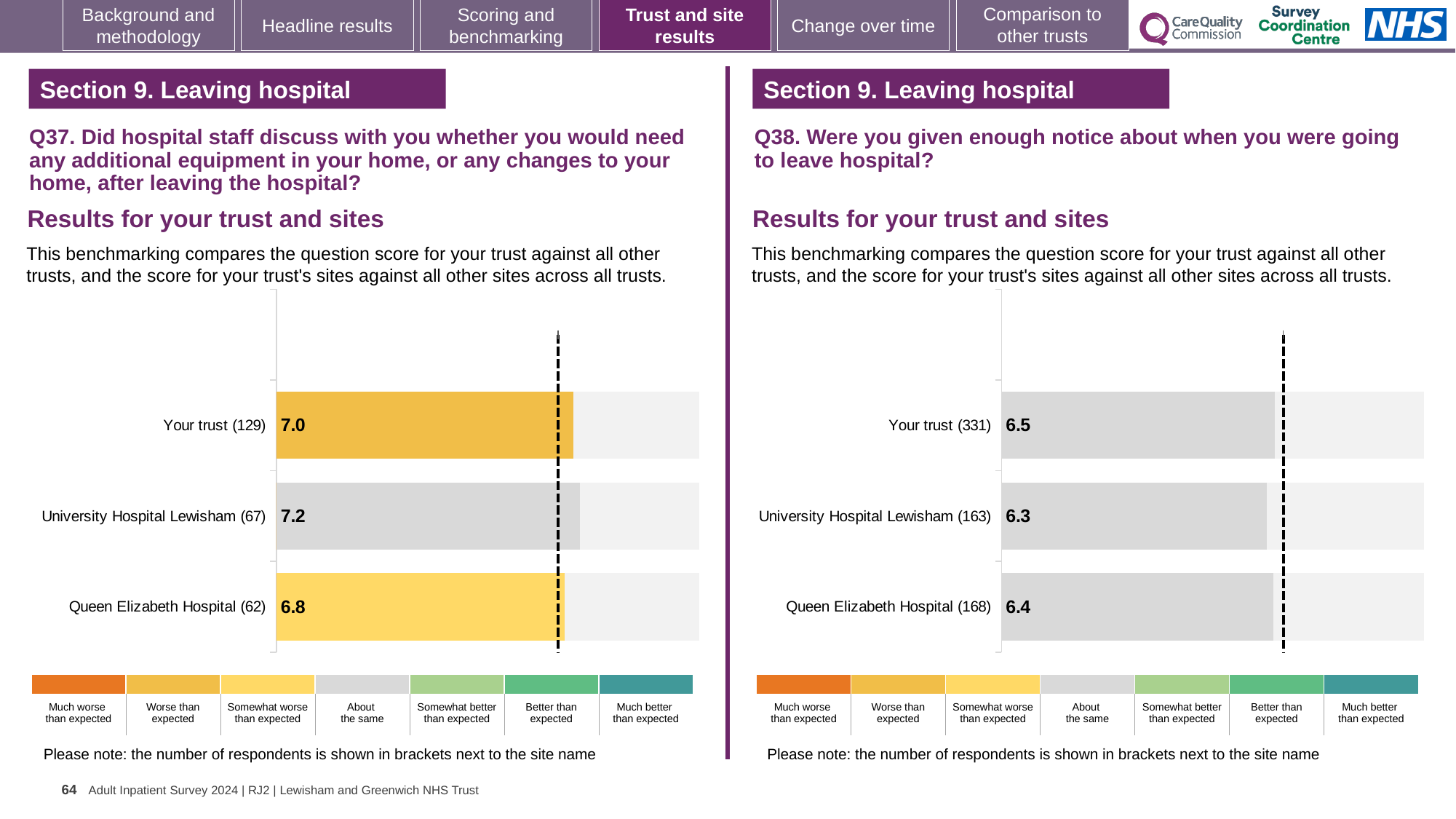
What type of chart is used on the right for Q38? Bar chart In the Q38 chart on the right, what is the difference between the scores for Your trust and University Hospital Lewisham? 0.2 In the Q37 chart on the left, how many bars are plotted? 3 In the Q37 chart on the left, what is the score for University Hospital Lewisham (67)? 7.2 In the Q37 chart on the left, which benchmark category does the colour of the Your trust bar correspond to? Worse than expected In the Q37 chart on the left, which site or trust has the lowest score? Queen Elizabeth Hospital (62) In the Q38 chart on the right, what is the score for Queen Elizabeth Hospital (168)? 6.4 In the Q38 chart on the right, which has the larger score, University Hospital Lewisham or Queen Elizabeth Hospital? Queen Elizabeth Hospital In the Q38 chart on the right, what is the score for Your trust (331)? 6.5 In the Q37 chart on the left, what is the score for Your trust (129)? 7.0 In the Q37 chart on the left, what is the difference between the scores for University Hospital Lewisham and Queen Elizabeth Hospital? 0.4 In the Q38 chart on the right, which site or trust has the highest score? Your trust (331)